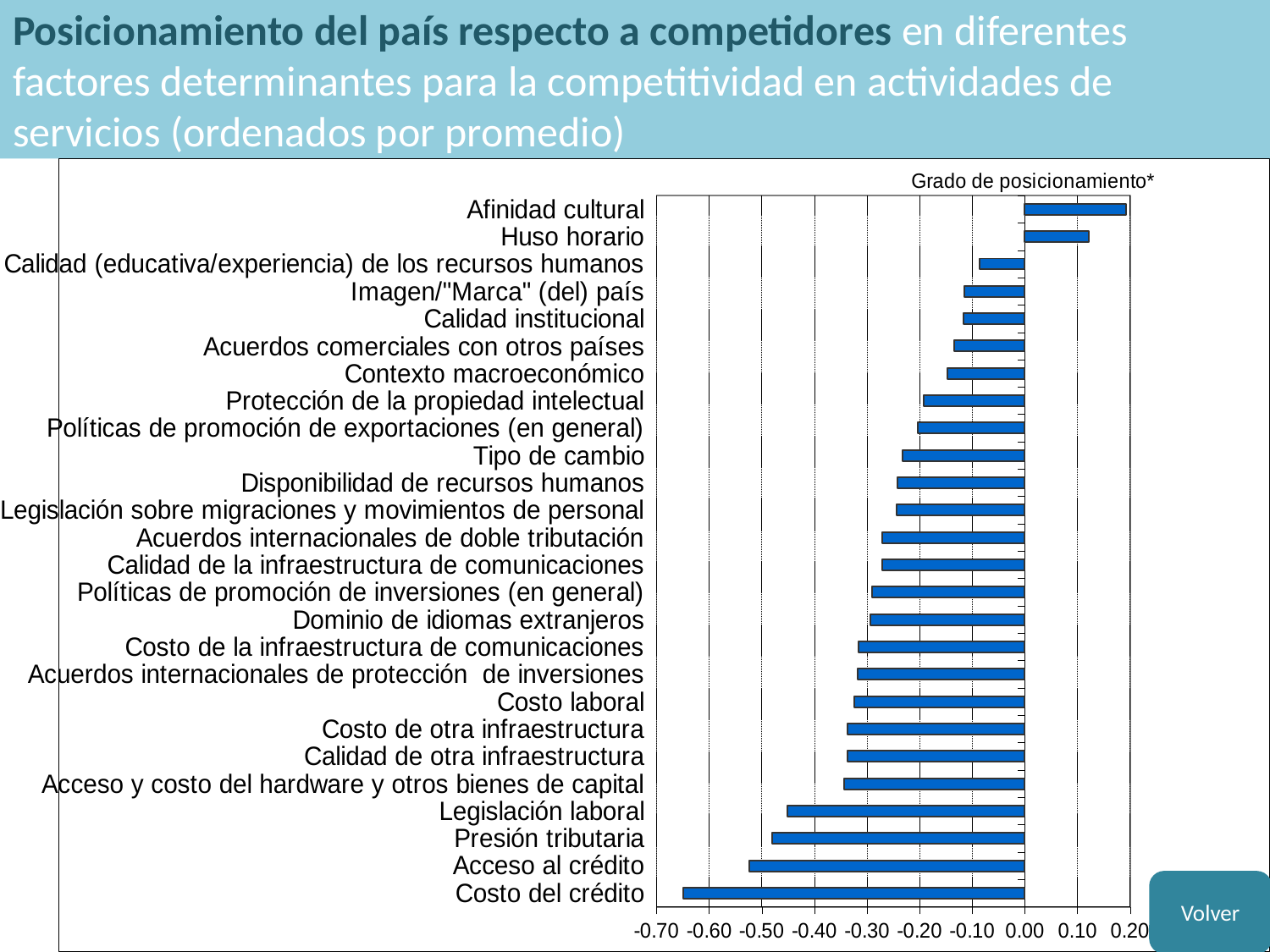
How many categories (factors) are plotted in the chart? 26 What kind of chart is shown on the slide? bar chart Is the value for Calidad institucional greater or less than -0.20? greater How many factors have a positive value in the chart? 2 Which has the larger value, Afinidad cultural or Huso horario? Afinidad cultural Is the value for Afinidad cultural greater or less than 0.10? greater Which factor has the highest value in the chart? Afinidad cultural Which factor has the lowest value in the chart? Costo del crédito Is the value for Legislación laboral greater or less than -0.40? less What is the label shown above the chart's value axis? Grado de posicionamiento* Which has the larger value, Costo del crédito or Acceso al crédito? Acceso al crédito